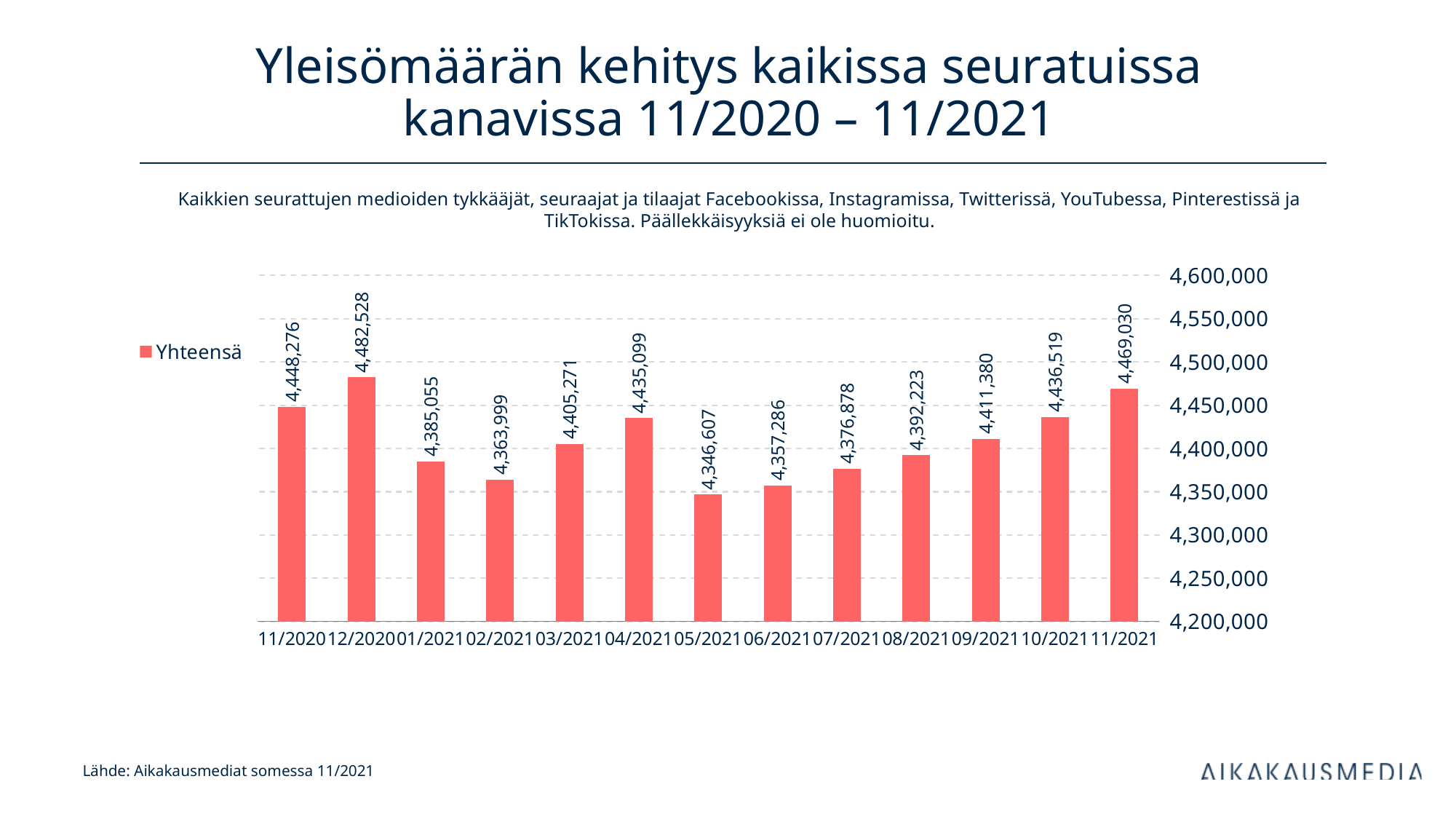
Is the value for 02/2021 greater or less than 4,400,000? less Which month has the lowest value? 05/2021 Which is larger, the value for 04/2021 or the value for 10/2021? 10/2021 What is the value for 11/2021? 4,469,030 What is the difference between the values for 11/2021 and 05/2021? 122,423 Do the values rise or fall from 05/2021 to 11/2021? rise Which month has the highest value? 12/2020 What is the value for 05/2021? 4,346,607 How many series does the legend list? 1 What is the difference between the values for 12/2020 and 11/2020? 34,252 What is the value for 11/2020? 4,448,276 How many months are shown on the x axis? 13